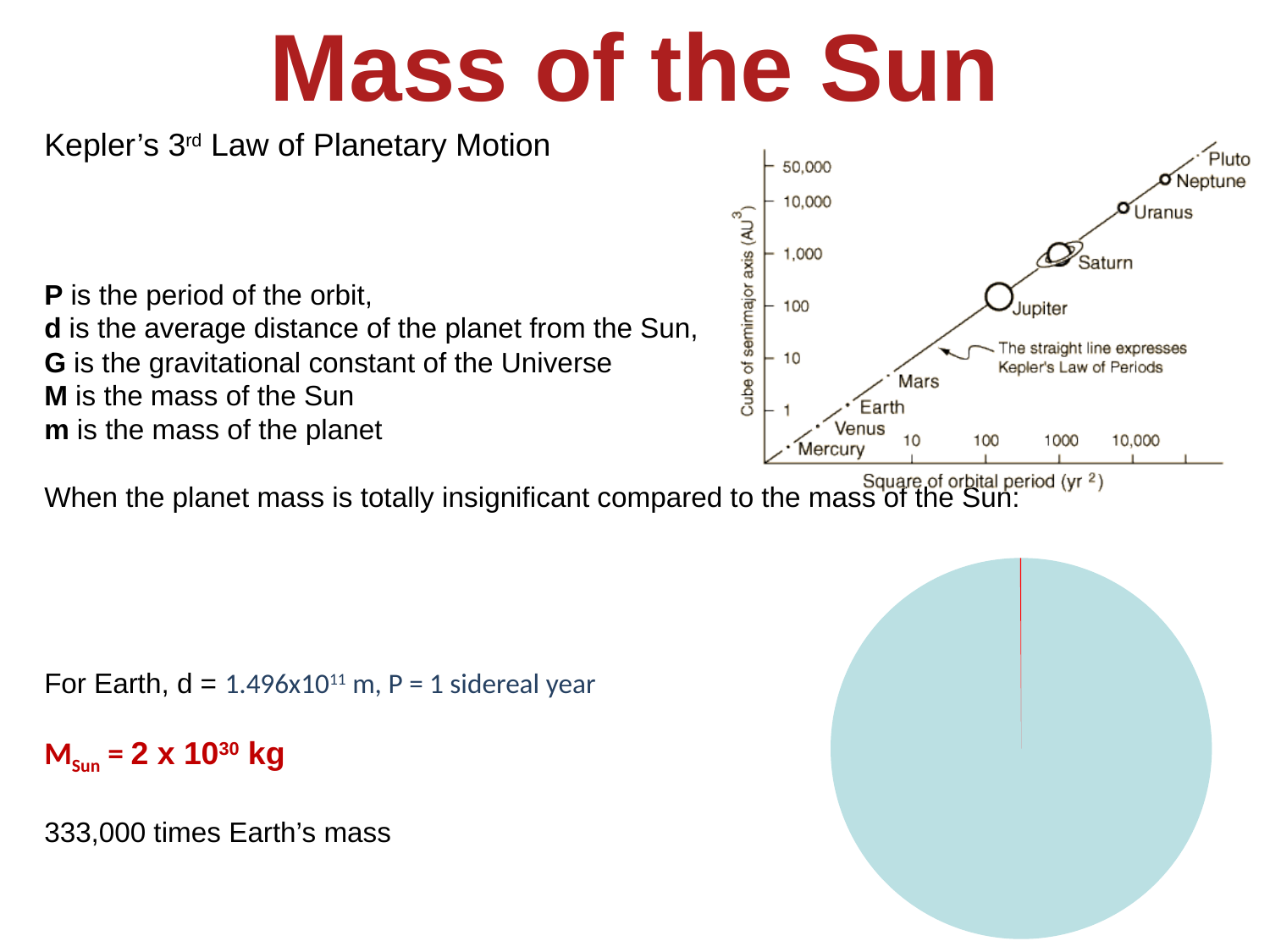
What colour is the large slice of the bottom-right pie chart? light blue In the top-right Kepler's Law chart, do the plotted values rise or fall as the square of orbital period increases? rise In the top-right Kepler's Law chart, is the cube of semimajor axis for Jupiter greater or less than 10? greater What kind of chart is the bottom-right chart on the slide? pie chart In the top-right Kepler's Law chart, how many planets are plotted? 9 In the top-right Kepler's Law chart, is the cube of semimajor axis for Mars greater or less than 10? less What kind of chart is the top-right chart showing Kepler's Law of Periods? scatter plot In the top-right Kepler's Law chart, which planet has the highest cube of semimajor axis? Pluto In the top-right Kepler's Law chart, which planet has the lowest cube of semimajor axis? Mercury In the top-right Kepler's Law chart, is the cube of semimajor axis for Neptune greater or less than 10,000? greater In the top-right Kepler's Law chart, which planet has a larger cube of semimajor axis, Saturn or Uranus? Uranus What is the x-axis label of the top-right Kepler's Law chart? Square of orbital period (yr²)